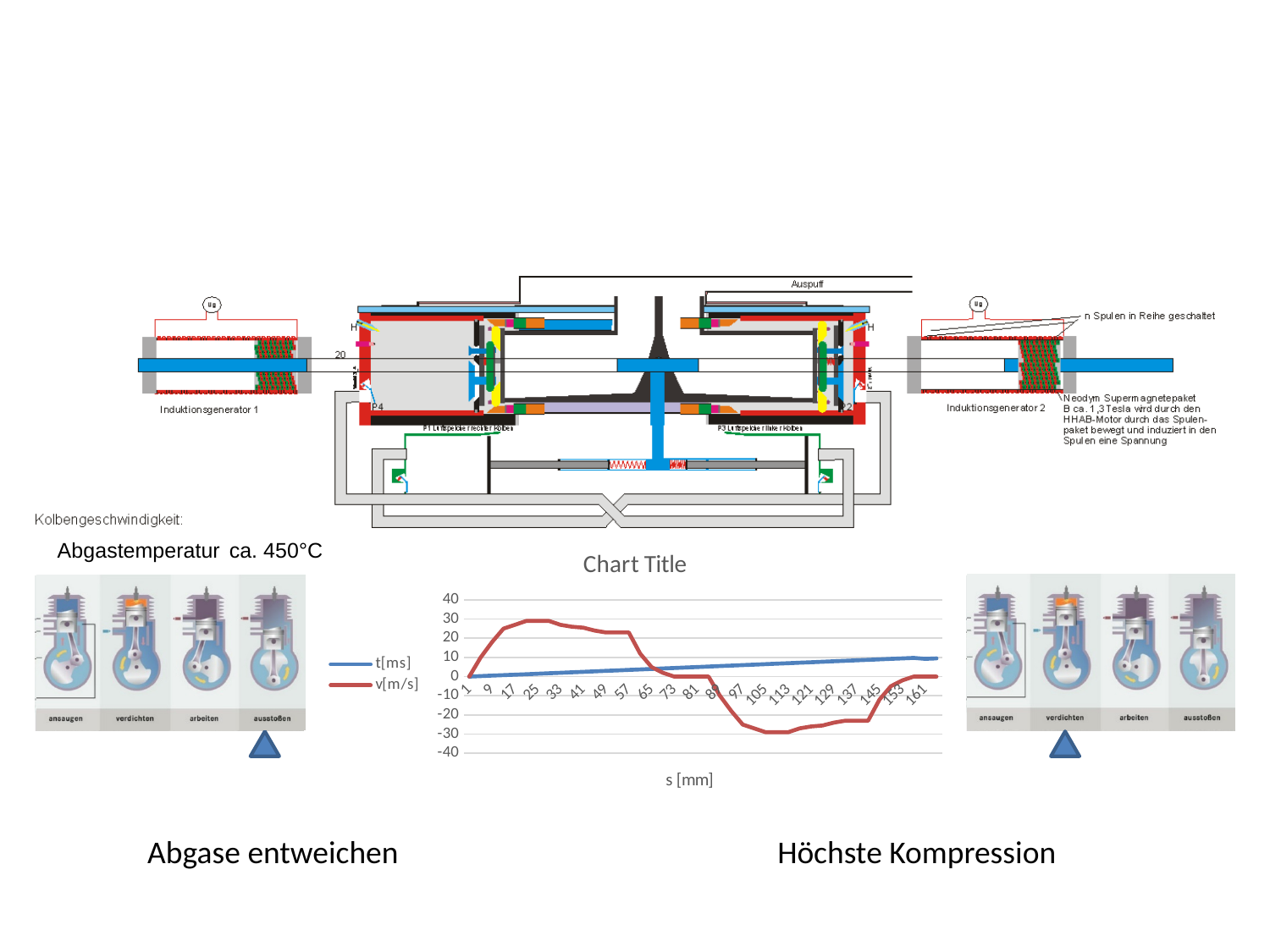
What kind of chart is shown on the slide? line chart Is the value of v[m/s] at s = 25 greater or less than 20? greater Does the t[ms] series rise or fall as s increases along the x axis? rise What is the title shown above the chart? Chart Title Is the value of t[ms] at s = 81 greater or less than 10? less Is the value of v[m/s] at s = 161 greater or less than -20? greater At s = 105, which series has the larger value, t[ms] or v[m/s]? t[ms] What is the label of the chart's x axis? s [mm] How many series does the chart's legend list? 2 How many tick labels are shown on the chart's x axis? 21 At s = 25, which series has the larger value, t[ms] or v[m/s]? v[m/s]